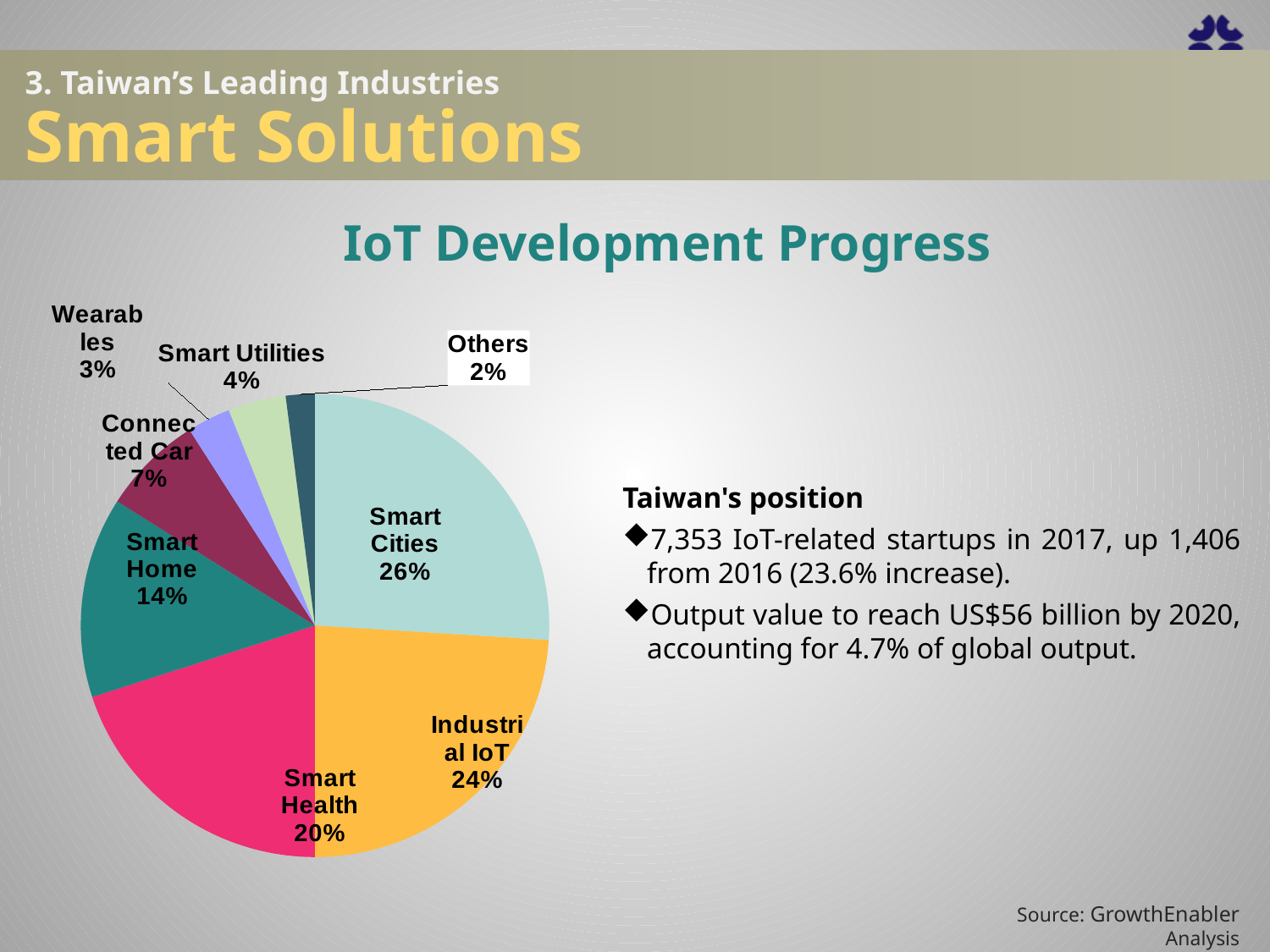
What is the title of the chart? IoT Development Progress What is the difference between the Smart Cities share and the Smart Home share? 12% What is the value shown for Smart Health? 20% Which category has the largest share of the pie? Smart Cities Which is larger, the share for Smart Utilities or the share for Wearables? Smart Utilities How many categories are shown in the pie chart? 8 What type of chart is shown on the slide? pie chart What is the value shown for Connected Car? 7% What share of the pie does Smart Cities account for? 26% What is the value shown for Smart Home? 14% What is the value shown for Industrial IoT? 24% Which category has the smallest share of the pie? Others